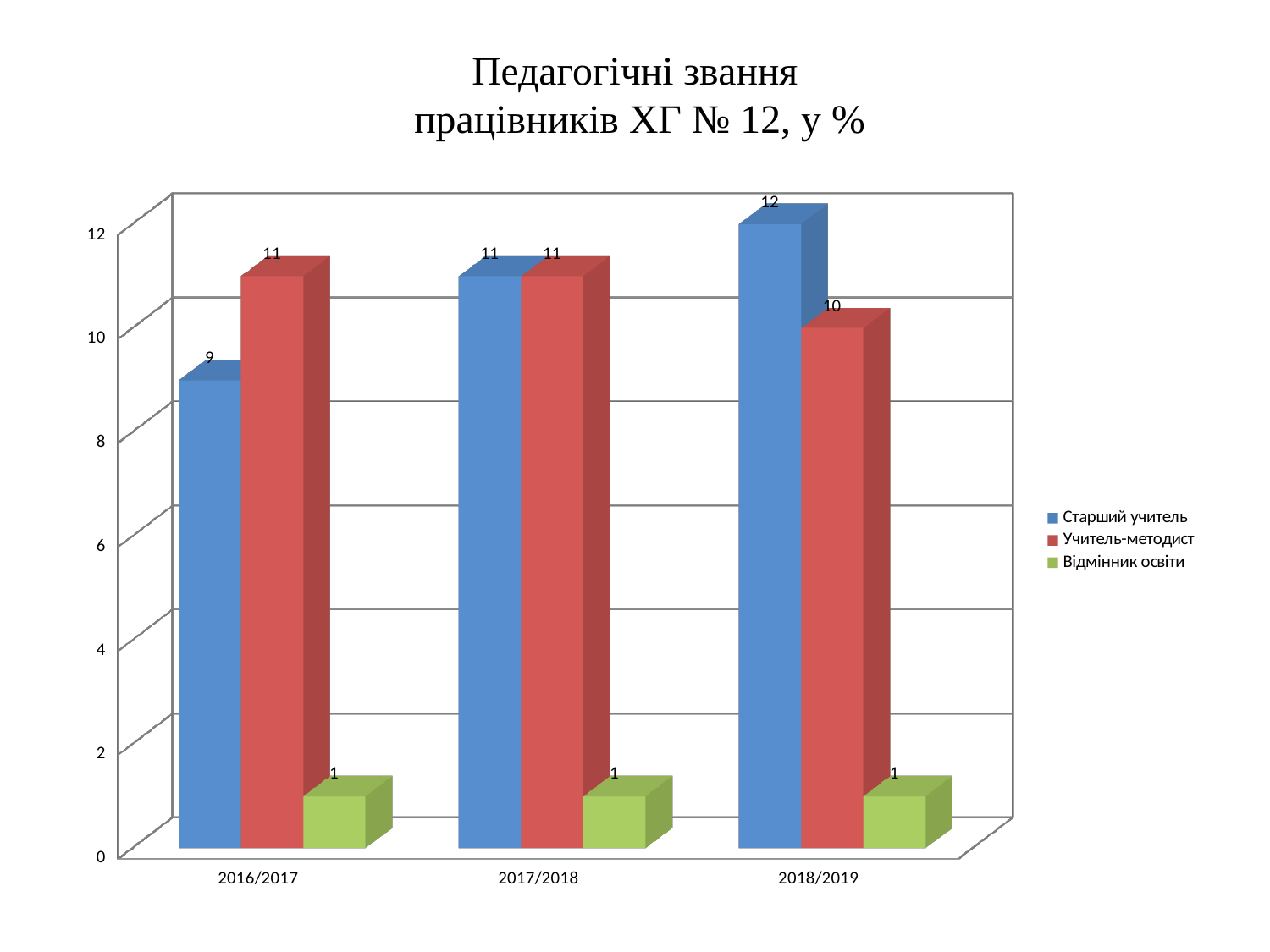
In which year is the value for Старший учитель highest? 2018/2019 What is the value for Відмінник освіти in 2017/2018? 1 Does the value for Старший учитель rise or fall from 2016/2017 to 2018/2019? rise What is the title of the chart? Педагогічні звання працівників ХГ № 12, у % What kind of chart is shown on the slide? bar chart In which year is the value for Учитель-методист lowest? 2018/2019 How many series does the legend list? 3 How many year categories are shown on the x axis? 3 What is the difference between Старший учитель and Учитель-методист in 2018/2019? 2 What is the value for Учитель-методист in 2018/2019? 10 What is the value for Старший учитель in 2016/2017? 9 Which is larger in 2016/2017: Старший учитель or Учитель-методист? Учитель-методист